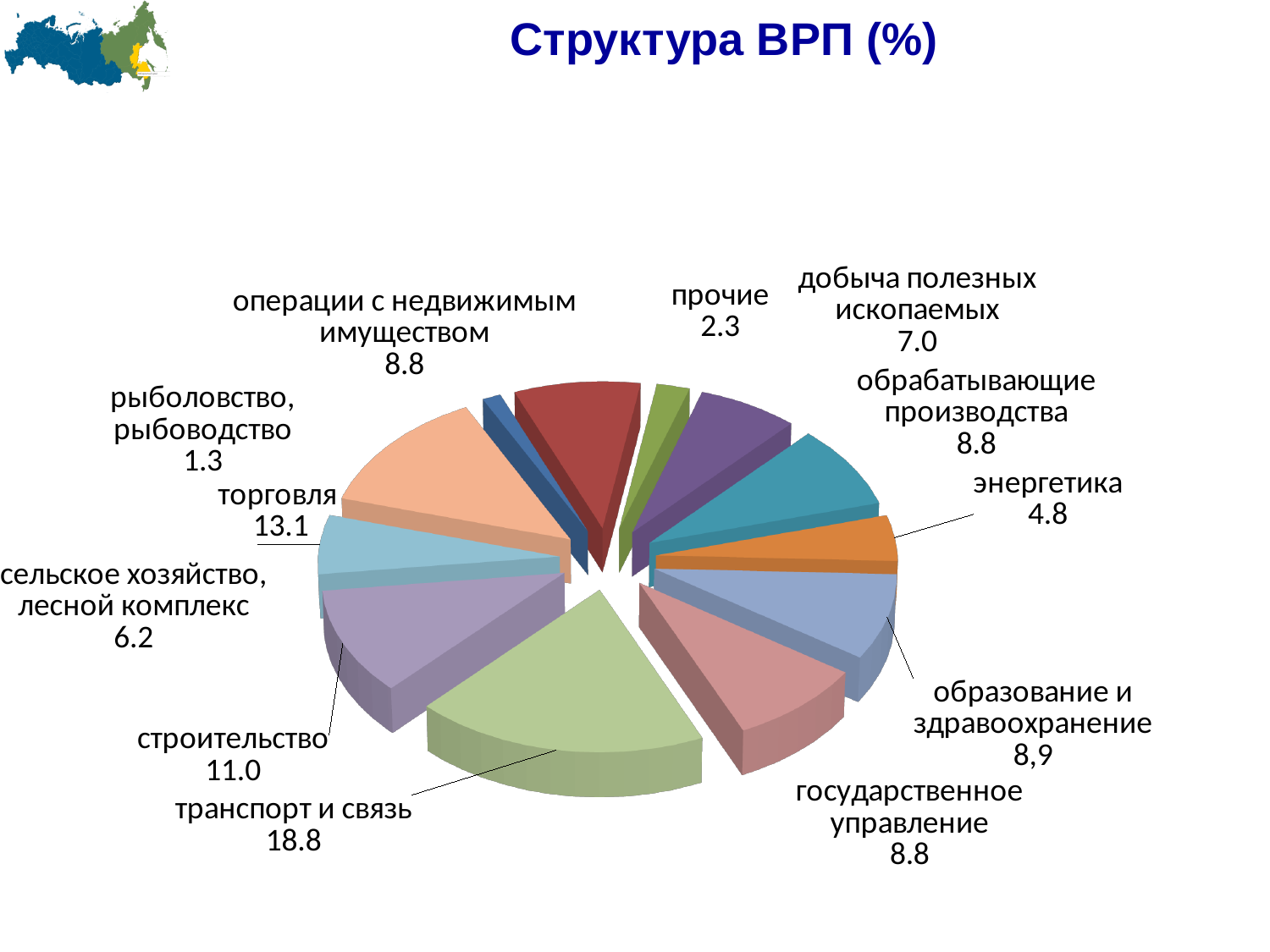
What is the value for транспорт и связь? 18.8 What is the value for энергетика? 4.8 Which is larger, the value for добыча полезных ископаемых or the value for сельское хозяйство, лесной комплекс? добыча полезных ископаемых What is the value for образование и здравоохранение? 8,9 What is the value for торговля? 13.1 What kind of chart is shown on the slide? pie chart Which category has the largest share of the pie? транспорт и связь What is the difference between the values for торговля and прочие? 10.8 What is the difference between the values for транспорт и связь and строительство? 7.8 Which category has the smallest share of the pie? рыболовство, рыбоводство How many categories (slices) does the pie chart have? 12 What is the title of the chart? Структура ВРП (%)